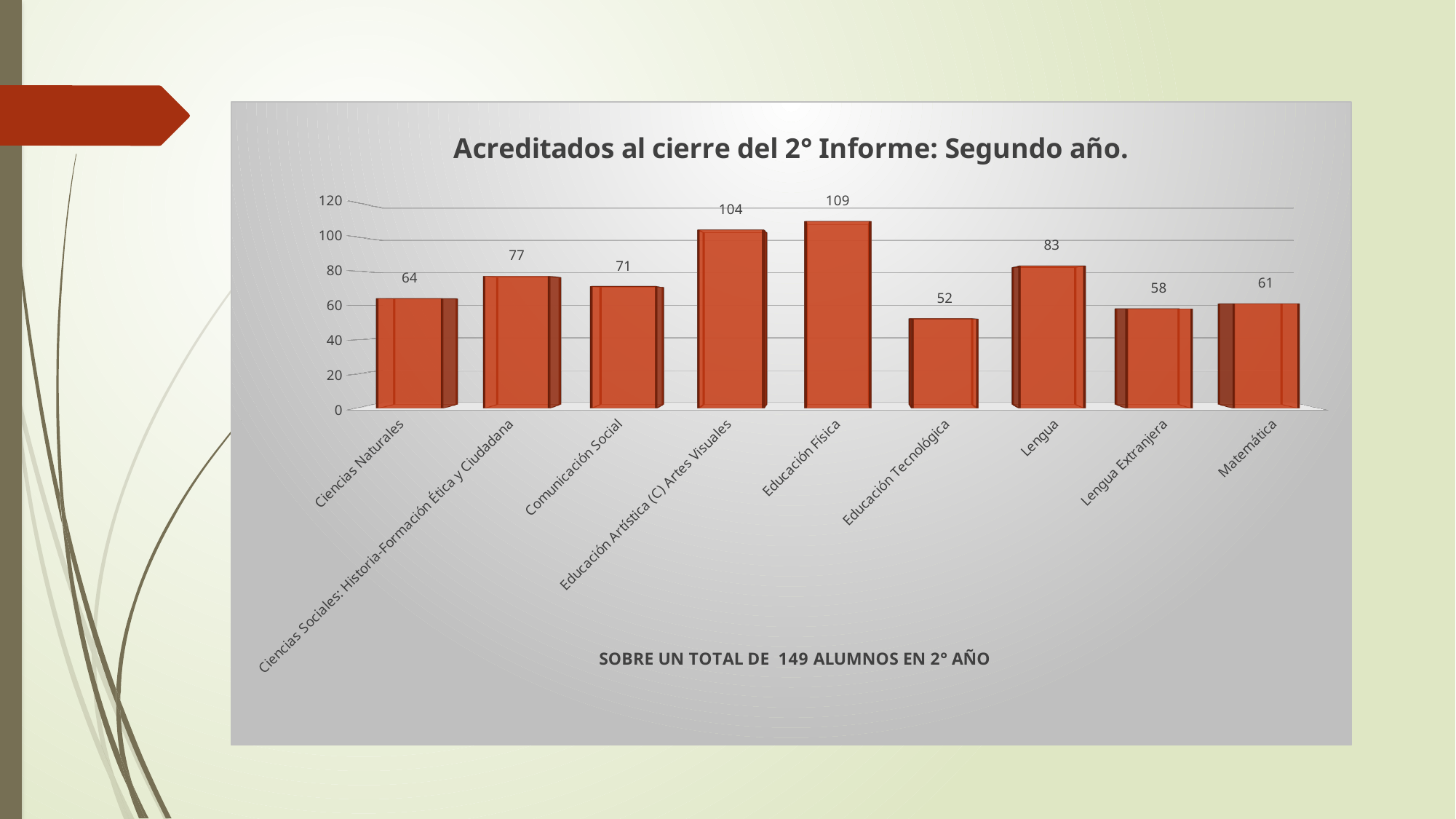
Is the value for Lengua greater or less than 80? greater What kind of chart is shown on the slide? bar chart What is the value for Educación Física? 109 What is the value for Ciencias Naturales? 64 Which is larger, the value for Comunicación Social or the value for Ciencias Sociales: Historia-Formación Ética y Ciudadana? Ciencias Sociales: Historia-Formación Ética y Ciudadana How many categories are shown in the chart? 9 What is the title of the chart? Acreditados al cierre del 2° Informe: Segundo año. What is the difference between the values for Lengua and Matemática? 22 Which category has the highest value? Educación Física What is the difference between the values for Educación Física and Educación Artística (C) Artes Visuales? 5 Which category has the lowest value? Educación Tecnológica What is the value for Lengua Extranjera? 58